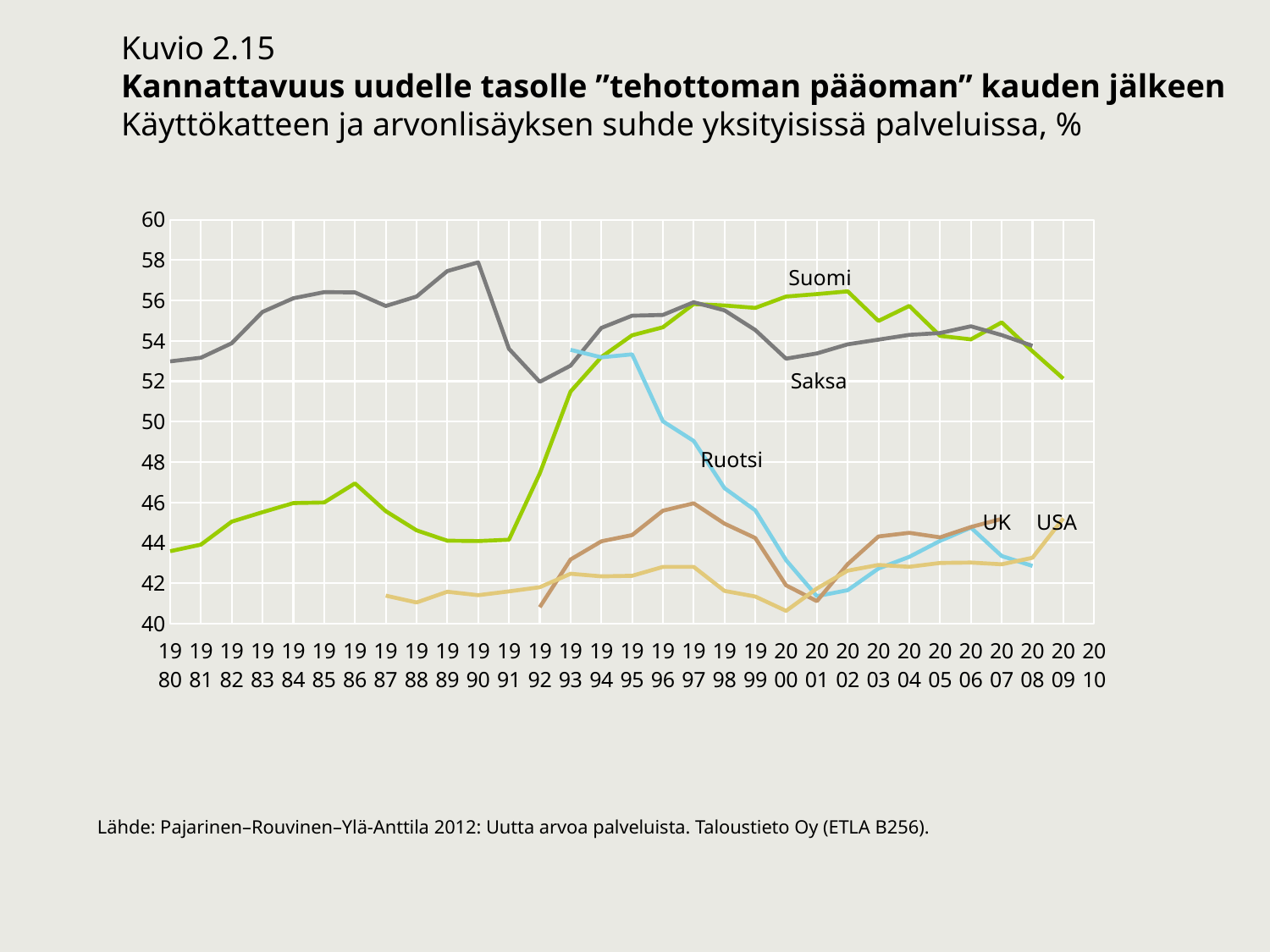
How many countries (series) are plotted in the chart? 5 Is the value for Saksa in 1990 greater or less than 56? greater Which series has the lowest value in 2000? USA Does the value for Ruotsi rise or fall from 1995 to 2001? fall Is the value for USA in 2000 greater or less than 42? less What kind of chart is shown on the slide? line chart Is the value for Suomi in 1980 greater or less than 46? less In 2002, which is larger: the value for Suomi or the value for Saksa? Suomi Which series has the highest value in 1990? Saksa In 1985, which is larger: the value for Suomi or the value for Saksa? Saksa